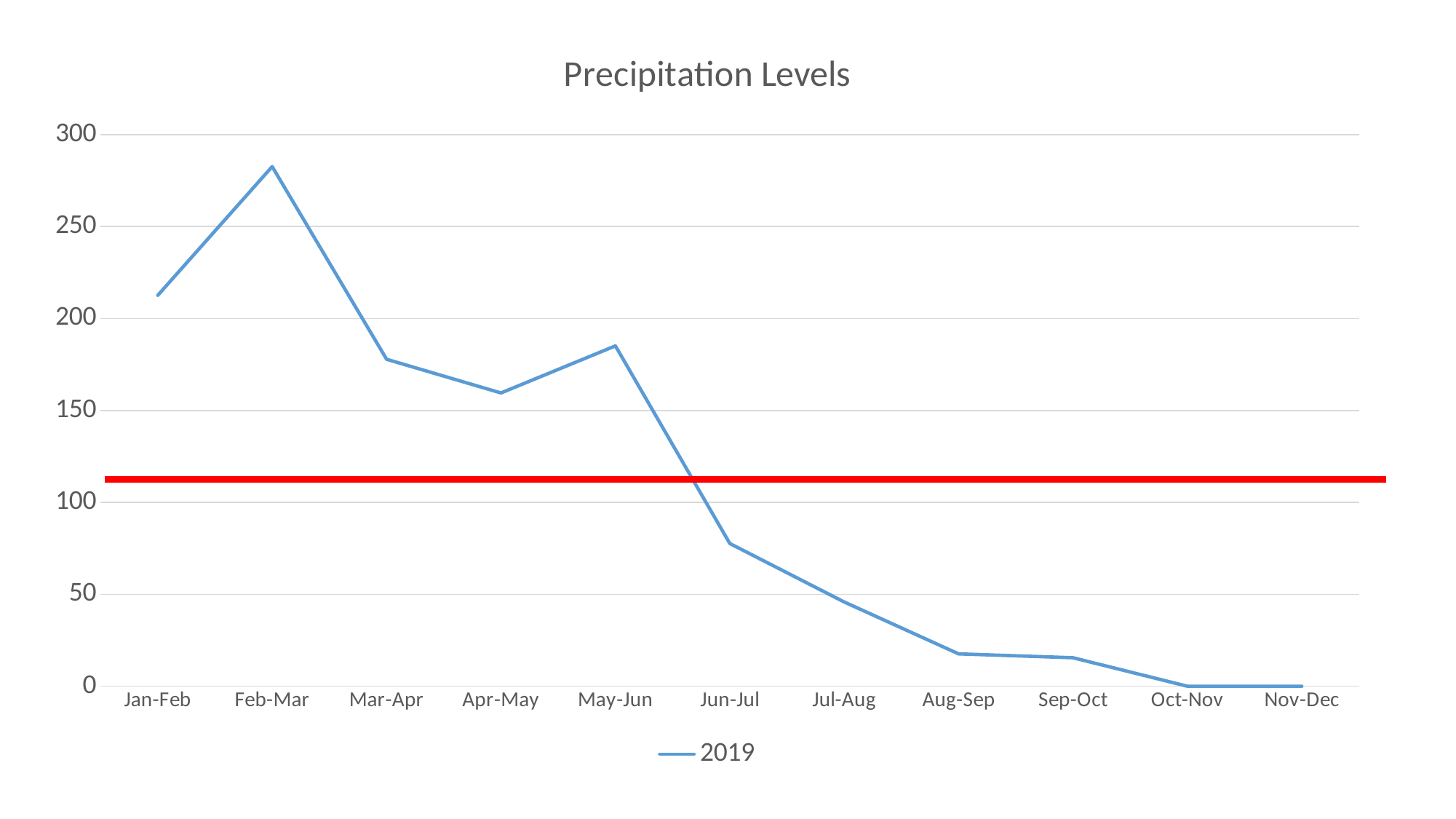
Is the value for Feb-Mar greater or less than 250? greater What colour is the horizontal reference line drawn across the chart? Red Is the value for Apr-May greater or less than 150? greater Is the value for Jun-Jul greater or less than 100? less Which is larger, the value for Jan-Feb or the value for Mar-Apr? Jan-Feb What is the title of the chart? Precipitation Levels How many categories are plotted along the x axis? 11 Do the precipitation values generally rise or fall from Feb-Mar to Nov-Dec? fall What type of chart is shown on the slide? Line chart How many series does the legend list? 1 Which category has the highest precipitation level? Feb-Mar